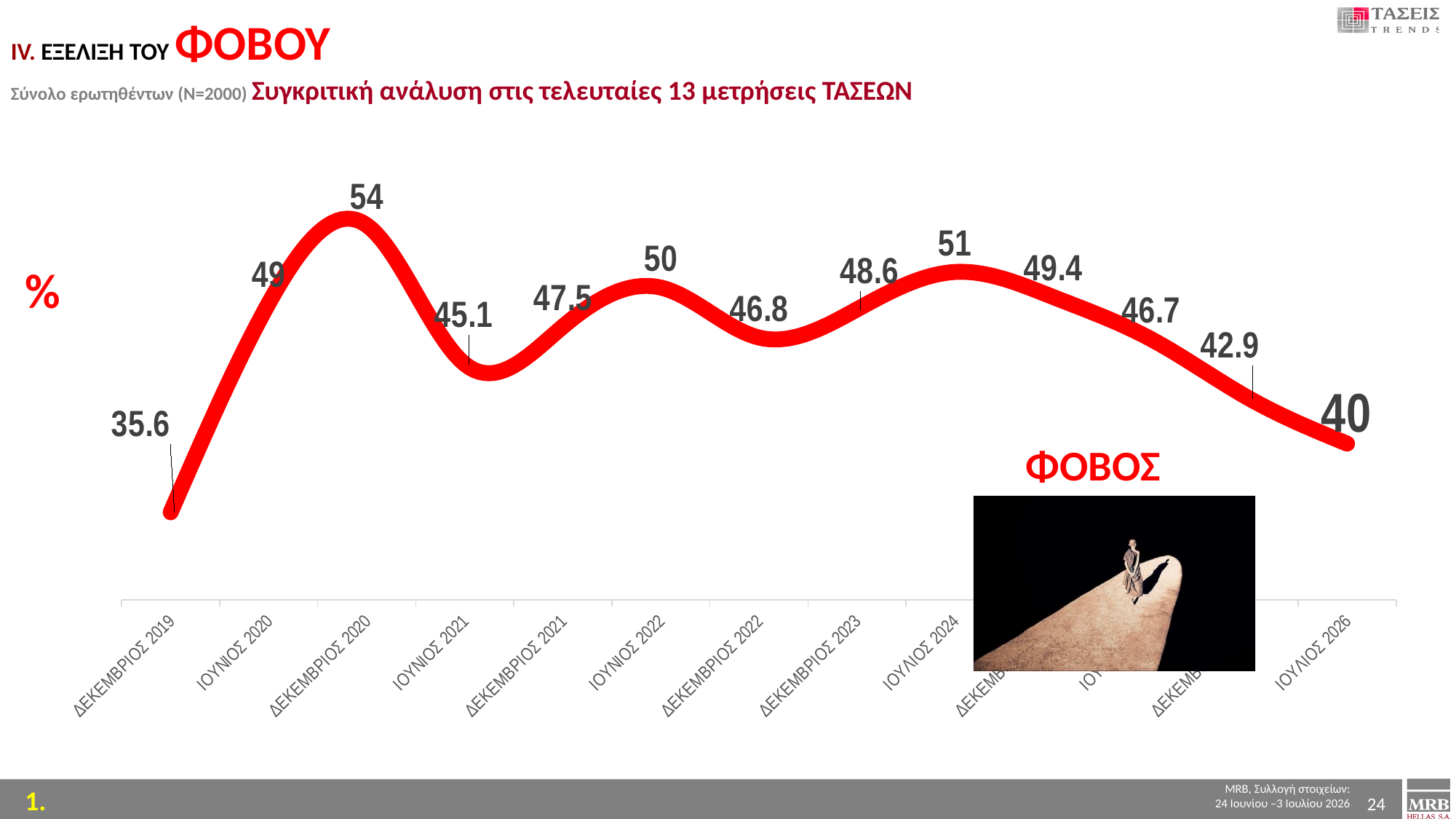
Which is larger, the value for ΙΟΥΛΙΟΣ 2024 or the value for ΔΕΚΕΜΒΡΙΟΣ 2023? ΙΟΥΛΙΟΣ 2024 Which measurement has the highest value? ΔΕΚΕΜΒΡΙΟΣ 2020 Which measurement has the lowest value? ΔΕΚΕΜΒΡΙΟΣ 2019 How many data points are plotted on the chart? 13 What is the name of the series plotted on the chart? ΦΟΒΟΣ What is the difference between the values for ΔΕΚΕΜΒΡΙΟΣ 2020 and ΔΕΚΕΜΒΡΙΟΣ 2019? 18.4 What is the value for ΙΟΥΛΙΟΣ 2026? 40 What kind of chart is shown on the slide? line chart What is the value for ΙΟΥΝΙΟΣ 2022? 50 What is the value for ΔΕΚΕΜΒΡΙΟΣ 2020? 54 What is the value for ΔΕΚΕΜΒΡΙΟΣ 2019? 35.6 Do the values rise or fall from ΙΟΥΛΙΟΣ 2024 to ΙΟΥΛΙΟΣ 2026? fall